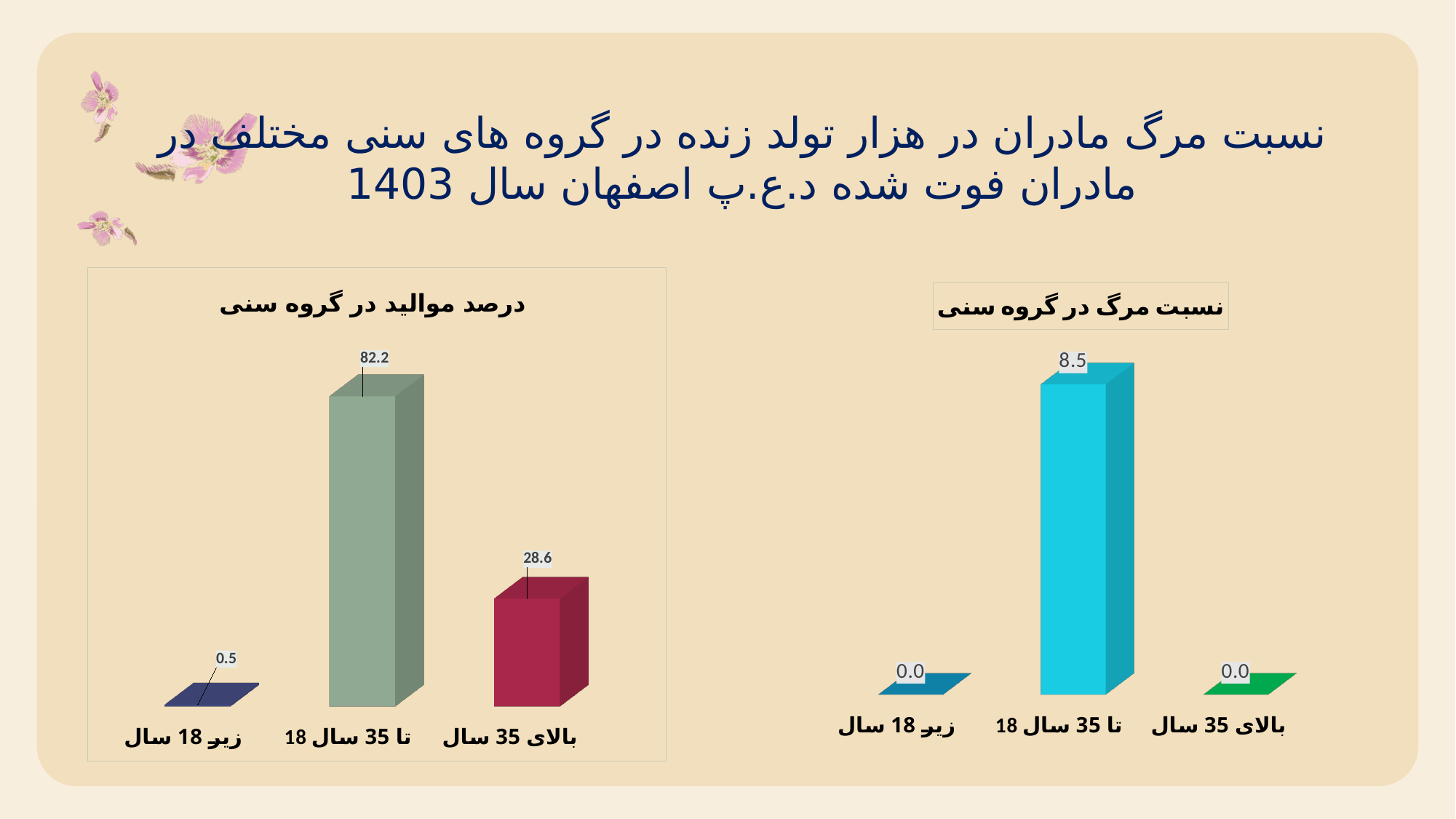
What type of chart is the left chart (درصد موالید در گروه سنی)? Bar chart In the left chart (درصد موالید در گروه سنی), which age group has the highest value? 18 تا 35 سال In the right chart (نسبت مرگ در گروه سنی), which age group has the highest value? 18 تا 35 سال In the right chart (نسبت مرگ در گروه سنی), what is the value for 18 تا 35 سال? 8.5 How many age groups are shown in the right chart (نسبت مرگ در گروه سنی)? 3 In the left chart (درصد موالید در گروه سنی), which age group has the lowest value? زیر 18 سال In the left chart (درصد موالید در گروه سنی), what is the value for زیر 18 سال? 0.5 In the left chart (درصد موالید در گروه سنی), which is larger: the value for بالای 35 سال or زیر 18 سال? بالای 35 سال In the right chart (نسبت مرگ در گروه سنی), what is the value for زیر 18 سال? 0.0 In the left chart (درصد موالید در گروه سنی), what is the difference between the values for 18 تا 35 سال and بالای 35 سال? 53.6 In the left chart (درصد موالید در گروه سنی), what is the value for بالای 35 سال? 28.6 In the left chart (درصد موالید در گروه سنی), what is the value for 18 تا 35 سال? 82.2